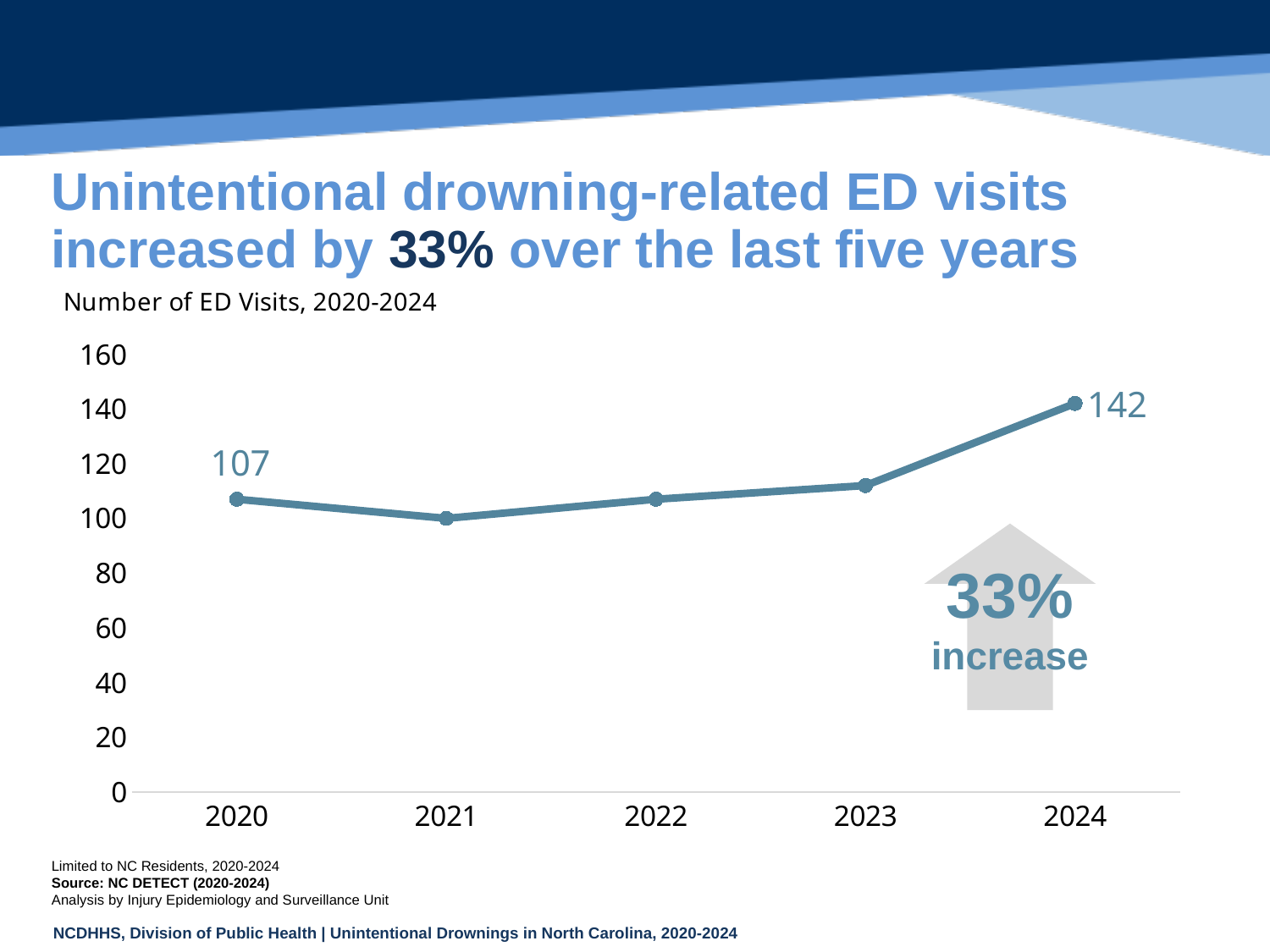
Do the ED visits rise or fall from 2023 to 2024? rise What kind of chart is shown on the slide? line chart What is the title of the chart? Number of ED Visits, 2020-2024 Which year has the lowest number of ED visits? 2021 Is the value for 2023 greater or less than 100? greater Is the value for 2021 greater or less than 120? less Which year has the highest number of ED visits? 2024 What is the number of ED visits in 2024? 142 By how much did the number of ED visits increase from 2020 to 2024? 35 Which year has more ED visits, 2020 or 2024? 2024 How many years are plotted on the chart? 5 What is the number of ED visits in 2020? 107